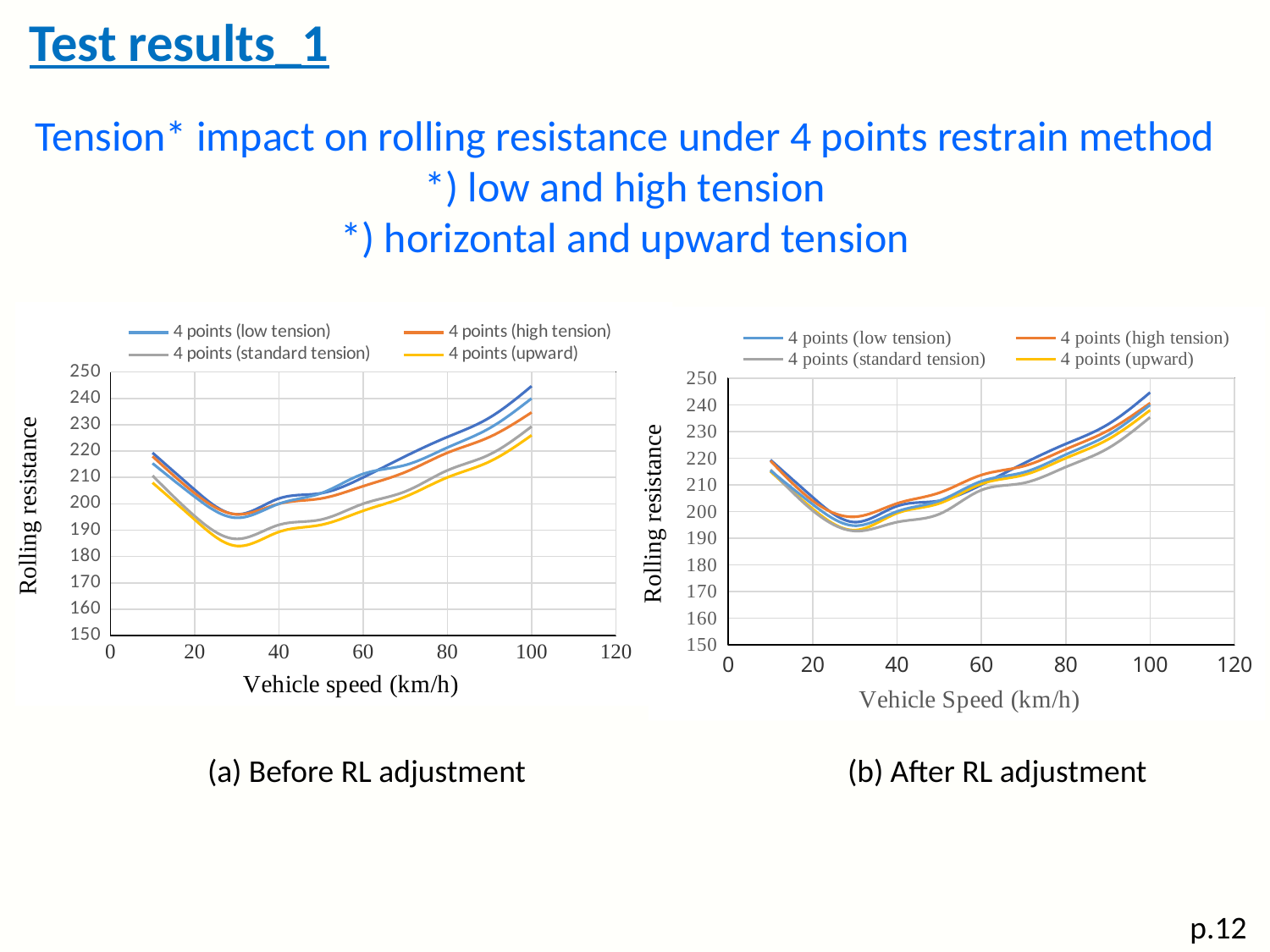
What is the x-axis title of chart (b) After RL adjustment? Vehicle Speed (km/h) What kind of chart is chart (a) Before RL adjustment? line chart In chart (a) Before RL adjustment, is the value for 4 points (upward) at 30 km/h greater or less than 190? less In chart (a) Before RL adjustment, which series has the lowest value at 100 km/h? 4 points (upward) In chart (a) Before RL adjustment, which series has the higher value at 30 km/h: 4 points (low tension) or 4 points (upward)? 4 points (low tension) How many series does the legend of chart (b) After RL adjustment list? 4 What is the y-axis title of chart (a) Before RL adjustment? Rolling resistance In chart (b) After RL adjustment, do the rolling resistance values rise or fall as vehicle speed increases from 40 to 100 km/h? rise In chart (a) Before RL adjustment, is the value for 4 points (upward) at 100 km/h greater or less than 230? less In chart (b) After RL adjustment, is the value for 4 points (standard tension) at 30 km/h greater or less than 200? less